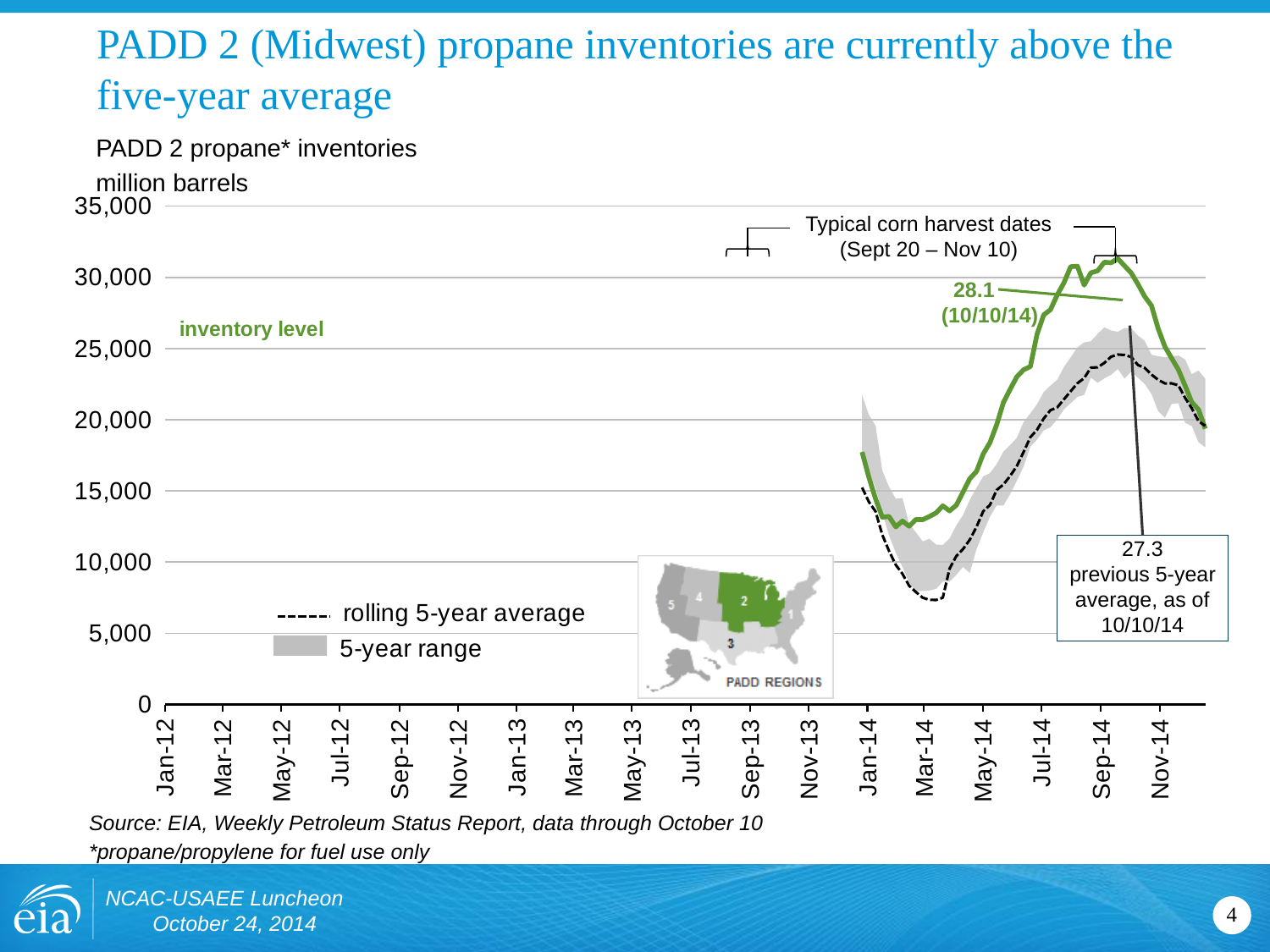
What is the highest value shown on the y axis? 35,000 What unit is shown for the y axis of the chart? million barrels Is the inventory level in Jan-14 greater or less than 20,000? less As of 10/10/14, which is larger: the inventory level or the previous 5-year average? inventory level Is the peak inventory level around Sep-14 greater or less than 30,000? greater Is the inventory level in Mar-14 greater or less than 15,000? less Does the inventory level rise or fall between Mar-14 and Sep-14? rise What typical corn harvest dates are annotated on the chart? Sept 20 – Nov 10 What kind of chart is shown on the slide? line chart By how much does the 10/10/14 inventory level (28.1) exceed the previous 5-year average (27.3)? 0.8 What is the previous 5-year average as of 10/10/14 shown in the callout box? 27.3 What is the PADD 2 propane inventory level labeled on the chart for 10/10/14? 28.1